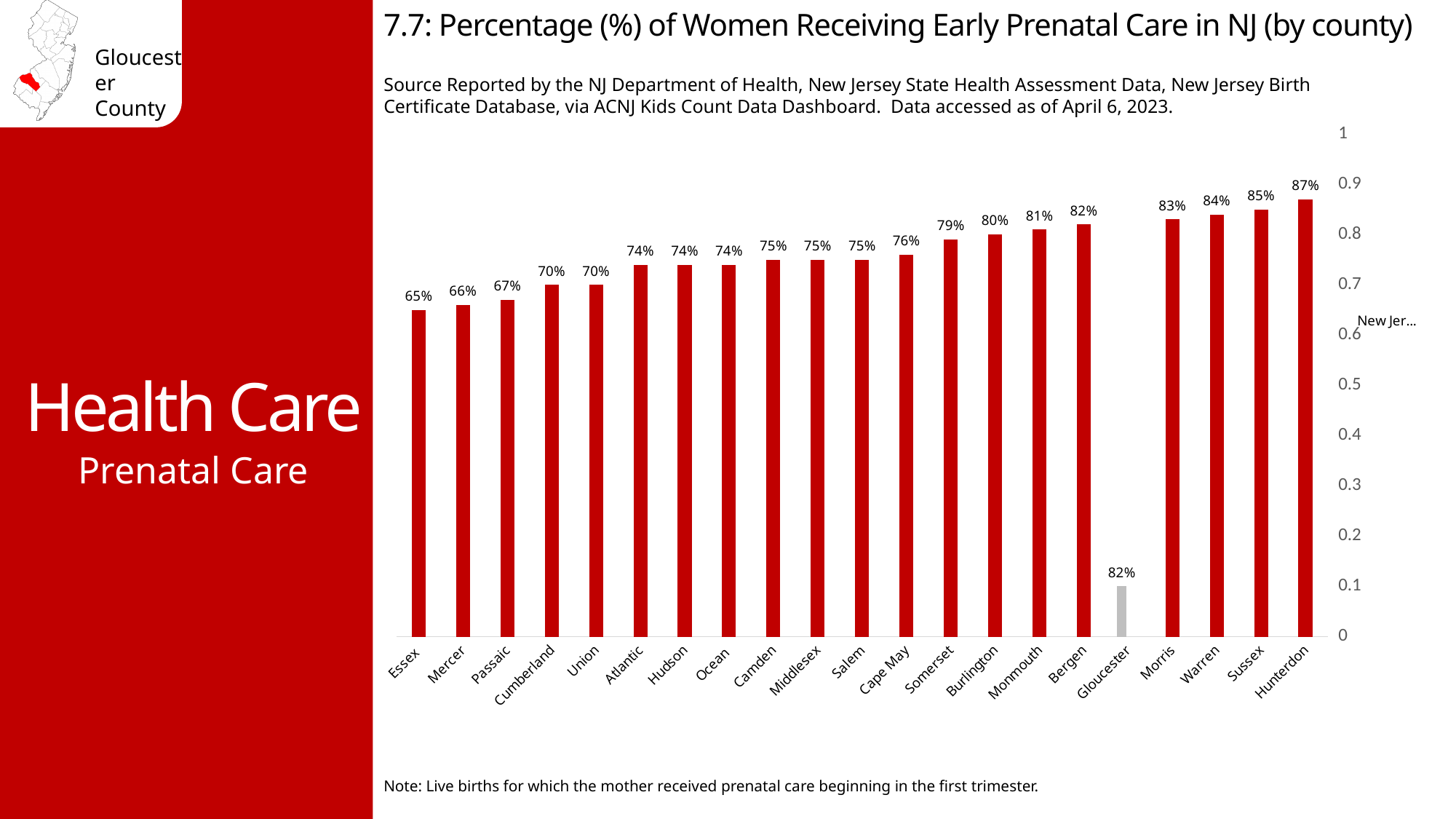
What is the value shown for Essex County? 65% How many counties are shown on the chart? 21 Which county's bar is coloured gray instead of red? Gloucester What is the value shown for Somerset County? 79% Which has a higher value, Morris or Bergen? Morris What percentage of women received early prenatal care in Gloucester County? 82% Which county has the highest percentage of women receiving early prenatal care? Hunterdon What kind of chart is shown on the slide? Bar chart What is the difference in percentage points between Hunterdon and Essex? 22 percentage points Which county has the lowest percentage of women receiving early prenatal care? Essex What is the value shown for Hunterdon County? 87% Do the values generally rise or fall moving from left to right along the x axis? Rise